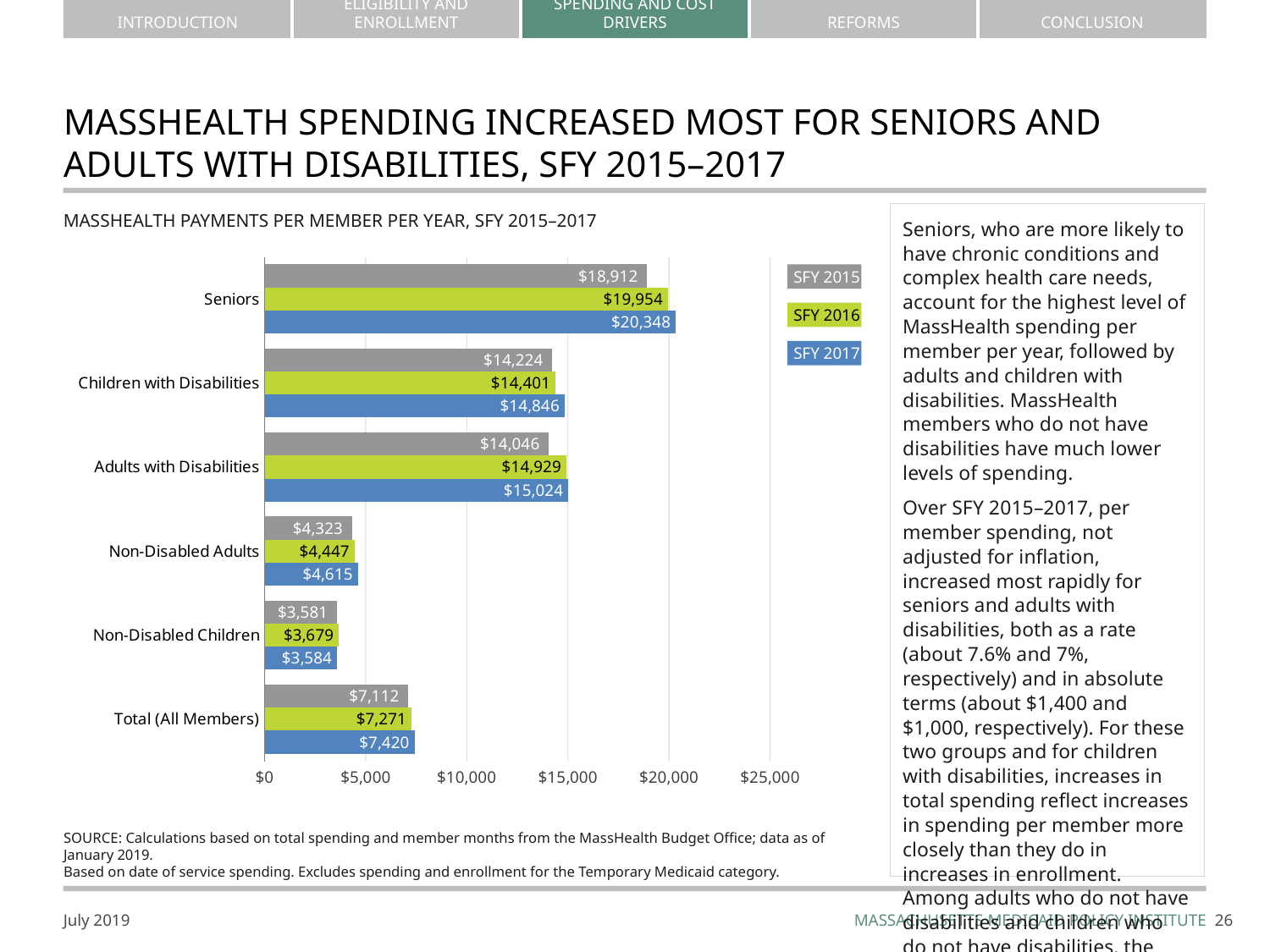
Which member category had the lowest payment per member per year in SFY 2015? Non-Disabled Children How many series does the chart legend list? 3 Which is larger: the SFY 2017 payment per member for Children with Disabilities or for Adults with Disabilities? Adults with Disabilities What was the MassHealth payment per member per year for Seniors in SFY 2017? $20,348 What was the payment per member per year for Adults with Disabilities in SFY 2016? $14,929 Is the SFY 2016 payment per member per year for Non-Disabled Adults greater or less than $5,000? less How many member categories are shown on the chart? 6 Which series is shown in blue in the chart? SFY 2017 Which member category had the highest payment per member per year in SFY 2017? Seniors What type of chart is used to show MassHealth payments per member per year? Bar chart What is the difference between the SFY 2017 and SFY 2015 payments per member per year for Seniors? $1,436 What was the payment per member per year for Non-Disabled Children in SFY 2015? $3,581